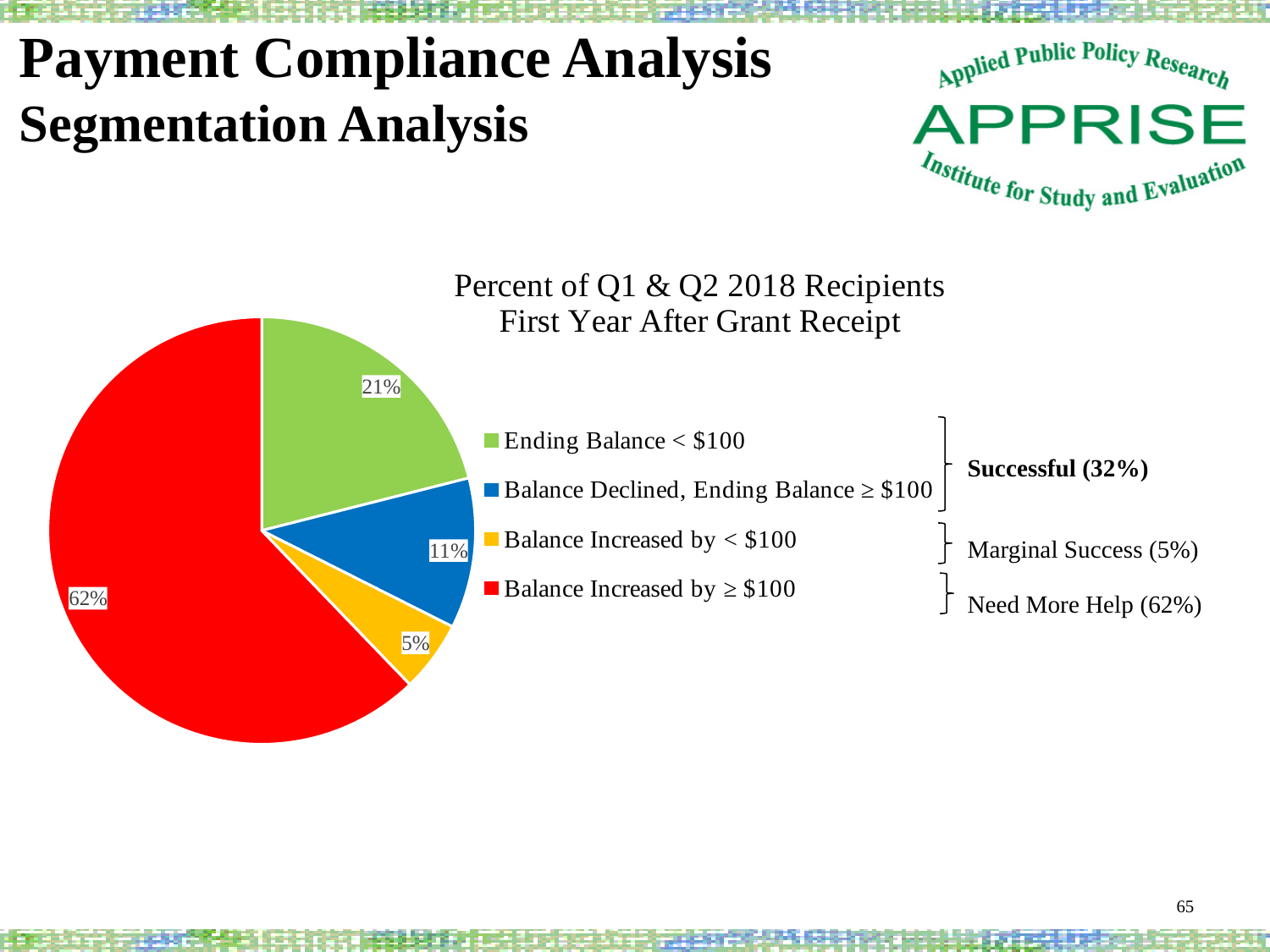
Which category has the largest share of the pie? Balance Increased by ≥ $100 What percentage of recipients had an Ending Balance < $100? 21% What is the difference in percentage points between Balance Increased by ≥ $100 and Ending Balance < $100? 41 Which category has the smallest share of the pie? Balance Increased by < $100 What percentage of recipients had Balance Increased by < $100? 5% How many slices does the pie chart have? 4 What is the chart's title? Percent of Q1 & Q2 2018 Recipients First Year After Grant Receipt What percentage of recipients had Balance Declined, Ending Balance ≥ $100? 11% Which colour represents Balance Increased by ≥ $100 in the pie chart? red What percentage of recipients had Balance Increased by ≥ $100? 62% What kind of chart is shown on the slide? pie chart Which is larger: the share for Ending Balance < $100 or the share for Balance Declined, Ending Balance ≥ $100? Ending Balance < $100